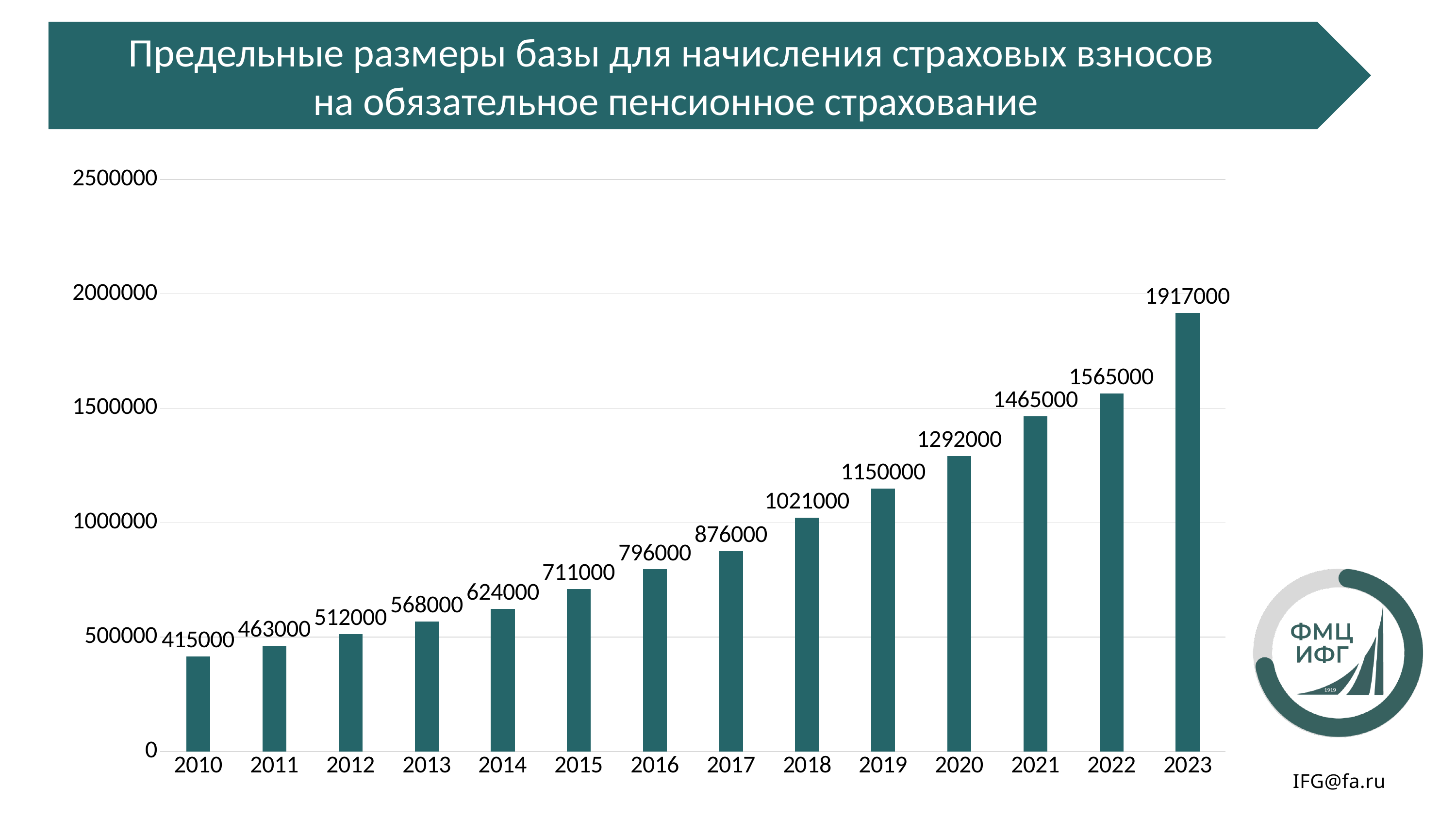
Which year has the lowest value? 2010 What is the value for 2010? 415000 What is the difference between the values for 2011 and 2010? 48000 What is the value for 2023? 1917000 Is the value for 2020 greater or less than 1000000? greater What is the difference between the values for 2023 and 2022? 352000 What kind of chart is shown on the slide? bar chart What is the value for 2018? 1021000 Which year has the highest value? 2023 Which is larger, the value for 2016 or the value for 2019? 2019 How many years are shown on the x axis? 14 Do the values rise or fall from 2010 to 2023? rise